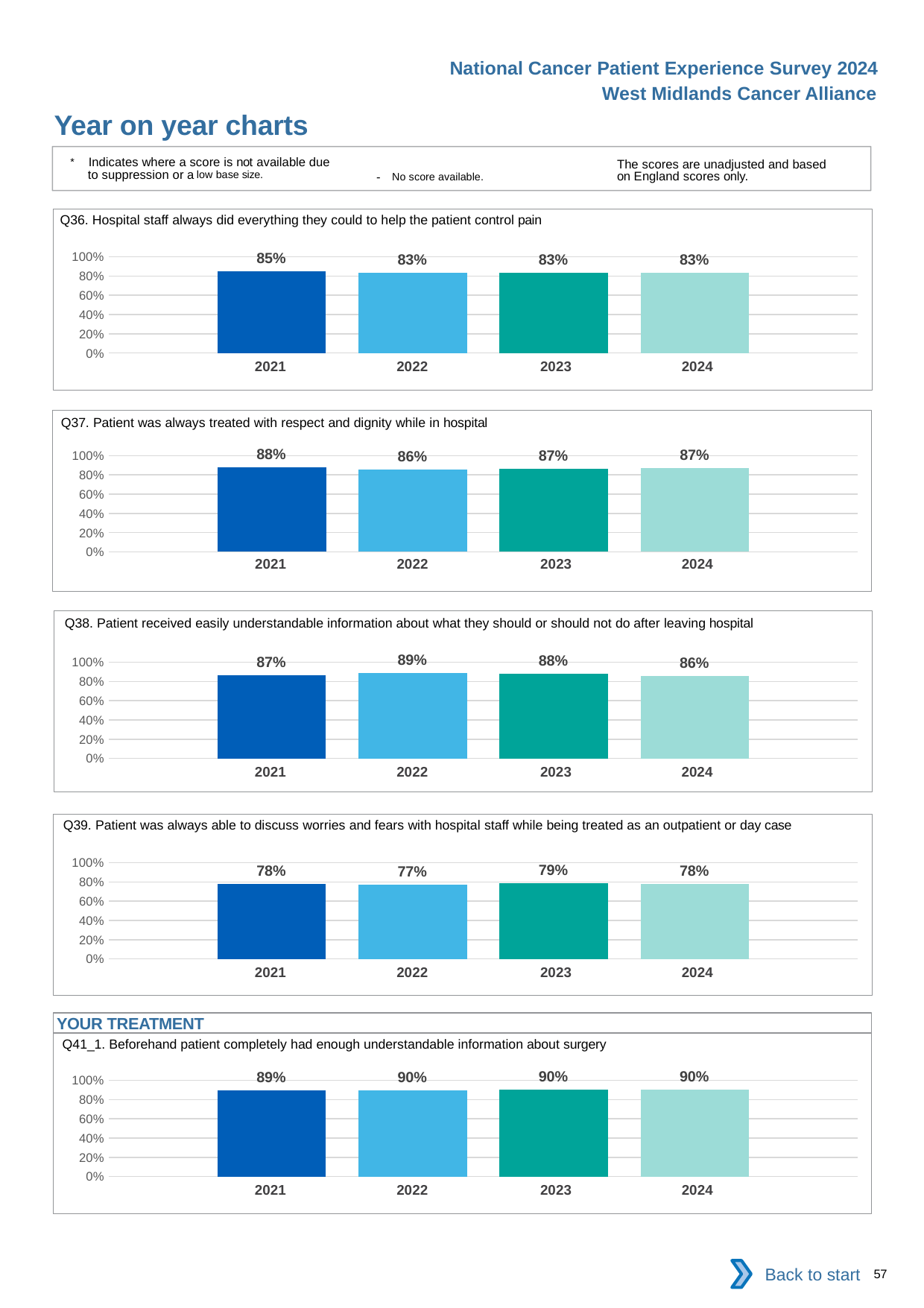
In the Q41_1 chart, is the value for 2022 larger or smaller than the value for 2021? larger In the Q41_1 chart (information about surgery), what is the value for 2021? 89% In the Q39 chart (discuss worries and fears as outpatient), what is the value for 2023? 79% How many years are shown in the Q36 chart? 4 In the Q36 chart, which year has the highest value? 2021 In the Q38 chart, which year has the lowest value? 2024 In the Q36 chart (hospital staff helped control pain), what is the value for 2021? 85% In the Q38 chart (understandable information after leaving hospital), which year has the highest value? 2022 In the Q37 chart (treated with respect and dignity), what is the value for 2022? 86% In the Q39 chart, which year has the lowest value? 2022 What type of chart is used for Q37? bar chart In the Q37 chart, what is the difference between the 2021 and 2022 values? 2 percentage points